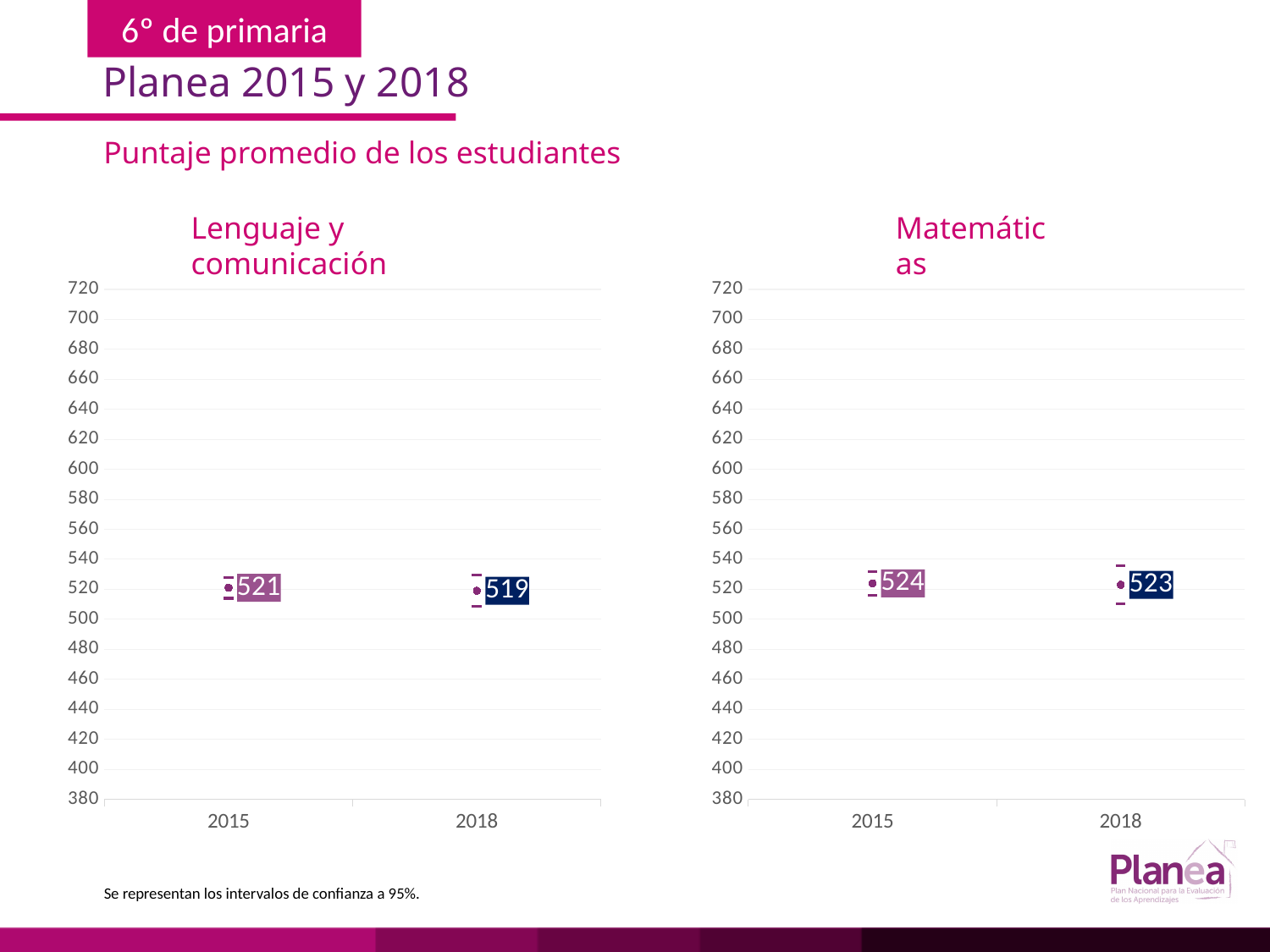
In the Matemáticas chart, what is the difference between the 2015 and 2018 scores? 1 In the Matemáticas chart, is the value for 2015 greater or less than 500? greater In the Lenguaje y comunicación chart, what is the average score for 2015? 521 In the Lenguaje y comunicación chart, what is the difference between the 2015 and 2018 scores? 2 In the Matemáticas chart, what is the average score for 2018? 523 In the Matemáticas chart, what is the average score for 2015? 524 In the Lenguaje y comunicación chart, what is the average score for 2018? 519 What is the title of the chart on the right side of the slide? Matemáticas In the Lenguaje y comunicación chart, which year has the higher score, 2015 or 2018? 2015 How many years are plotted on the x axis of the Matemáticas chart? 2 In the Lenguaje y comunicación chart, does the score rise or fall from 2015 to 2018? fall In the Matemáticas chart, which year has the lower score? 2018